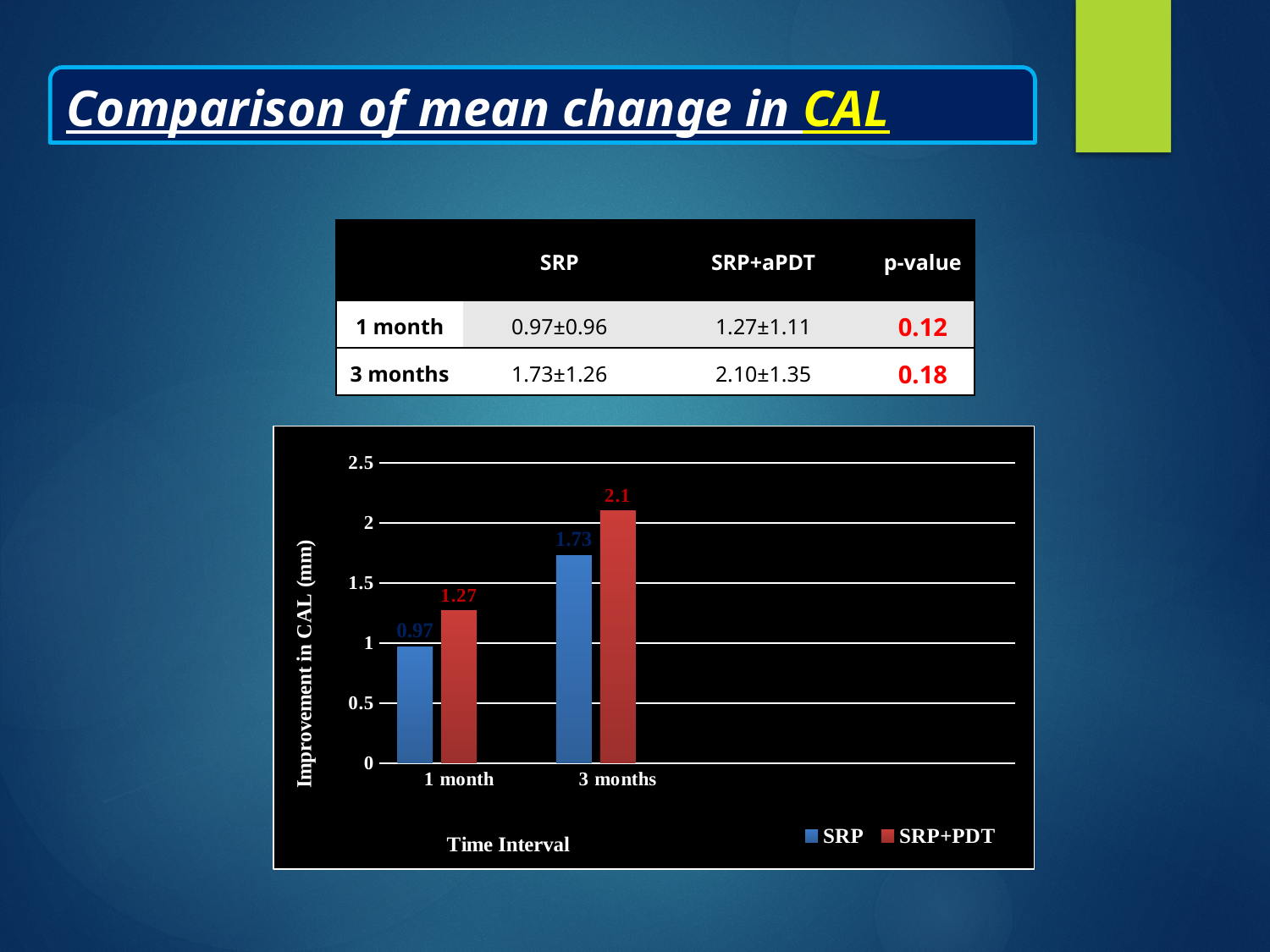
What is the label of the y axis? Improvement in CAL (mm) What is the value for SRP+PDT at 3 months? 2.1 What is the value for SRP at 1 month? 0.97 How many series does the legend list? 2 What is the value for SRP at 3 months? 1.73 What is the value for SRP+PDT at 1 month? 1.27 What kind of chart is shown? Bar chart What is the difference between SRP+PDT and SRP at 3 months? 0.37 Which is larger at 1 month, SRP or SRP+PDT? SRP+PDT Which bar has the highest value in the chart? SRP+PDT at 3 months Which bar has the lowest value in the chart? SRP at 1 month How many time intervals are shown on the x axis? 2